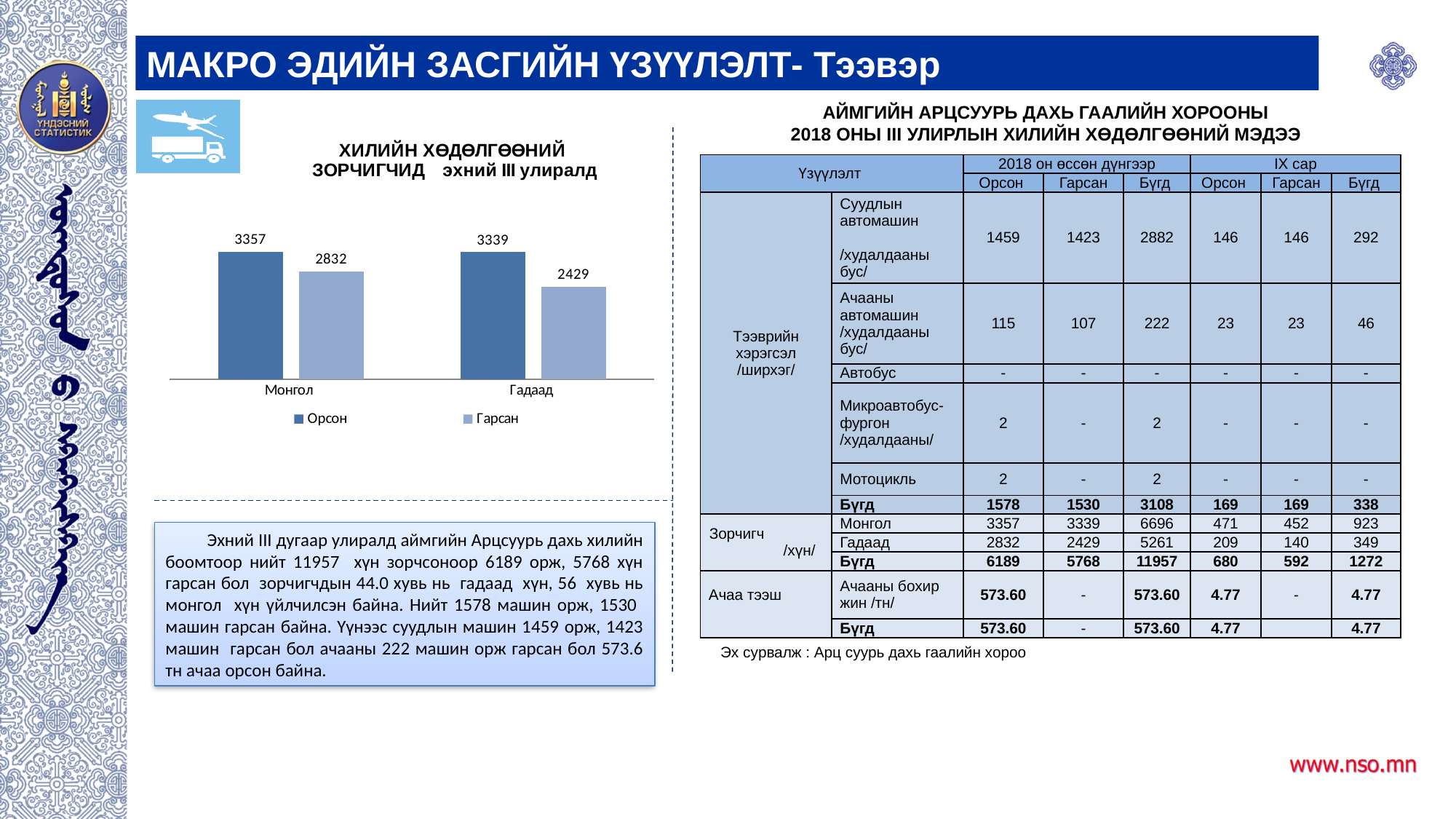
Which bar in the chart has the lowest value? Гарсан for Гадаад What type of chart is shown on the slide? bar chart What is the value of Орсон for Гадаад in the chart? 3339 What is the value of Орсон for Монгол in the chart? 3357 How many series does the chart legend list? 2 How many categories are shown on the x axis of the chart? 2 Which is larger in the chart: Гарсан for Монгол or Гарсан for Гадаад? Гарсан for Монгол What are the two series named in the chart legend? Орсон and Гарсан What is the value of Гарсан for Гадаад in the chart? 2429 What is the value of Гарсан for Монгол in the chart? 2832 What is the difference between Орсон and Гарсан for Гадаад in the chart? 910 What is the difference between Орсон and Гарсан for Монгол in the chart? 525